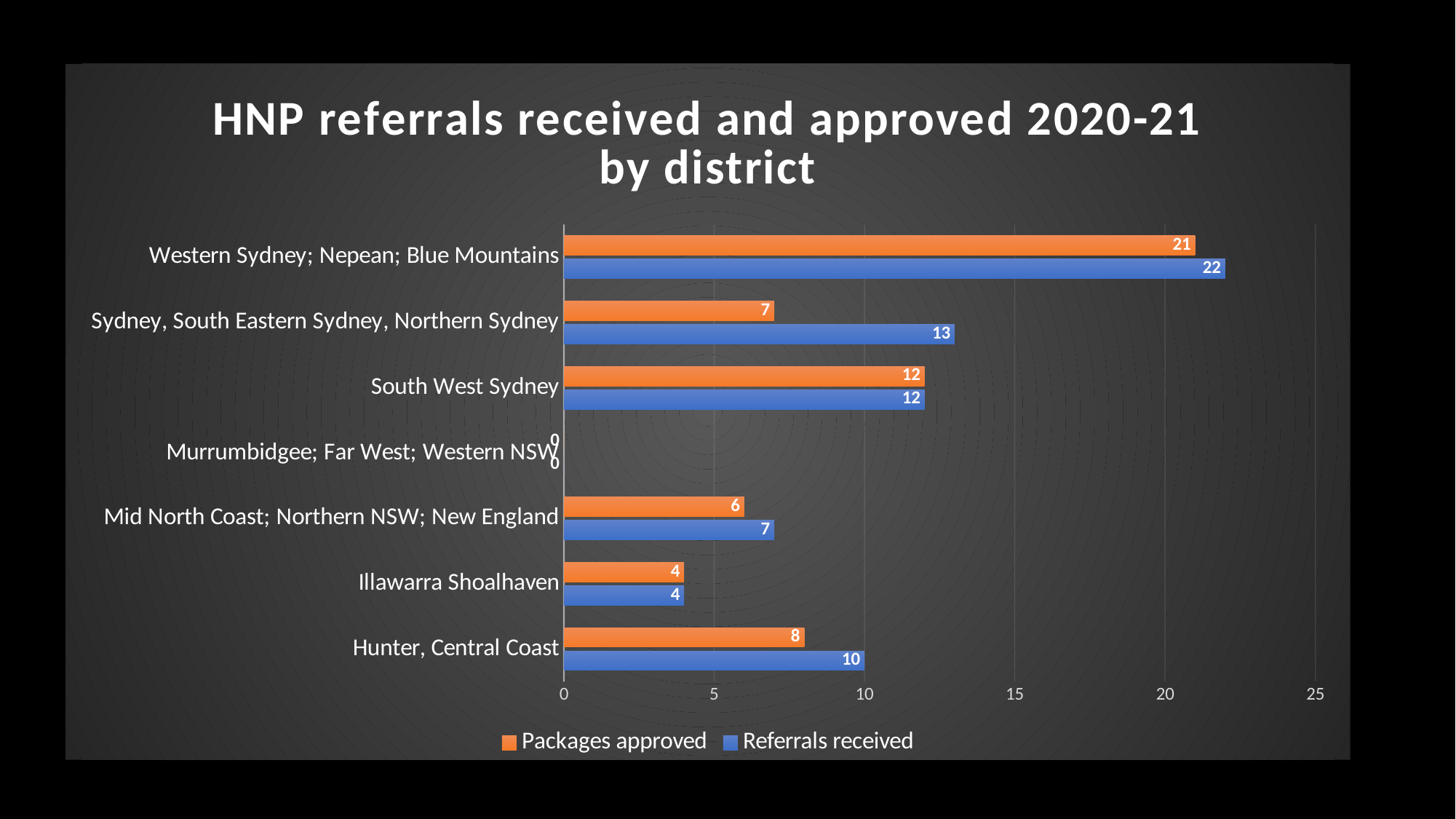
How many districts are shown on the chart? 7 What kind of chart is shown on the slide? Bar chart How many referrals were received for Western Sydney; Nepean; Blue Mountains? 22 Which colour represents Packages approved in the legend? Orange What is the title of the chart? HNP referrals received and approved 2020-21 by district Which district had the lowest number of packages approved? Murrumbidgee; Far West; Western NSW How many packages were approved for Sydney, South Eastern Sydney, Northern Sydney? 7 How many series does the legend list? 2 How many referrals were received for Hunter, Central Coast? 10 Which is larger for Hunter, Central Coast: referrals received or packages approved? Referrals received Which district had the highest number of referrals received? Western Sydney; Nepean; Blue Mountains What is the difference between referrals received and packages approved for Sydney, South Eastern Sydney, Northern Sydney? 6